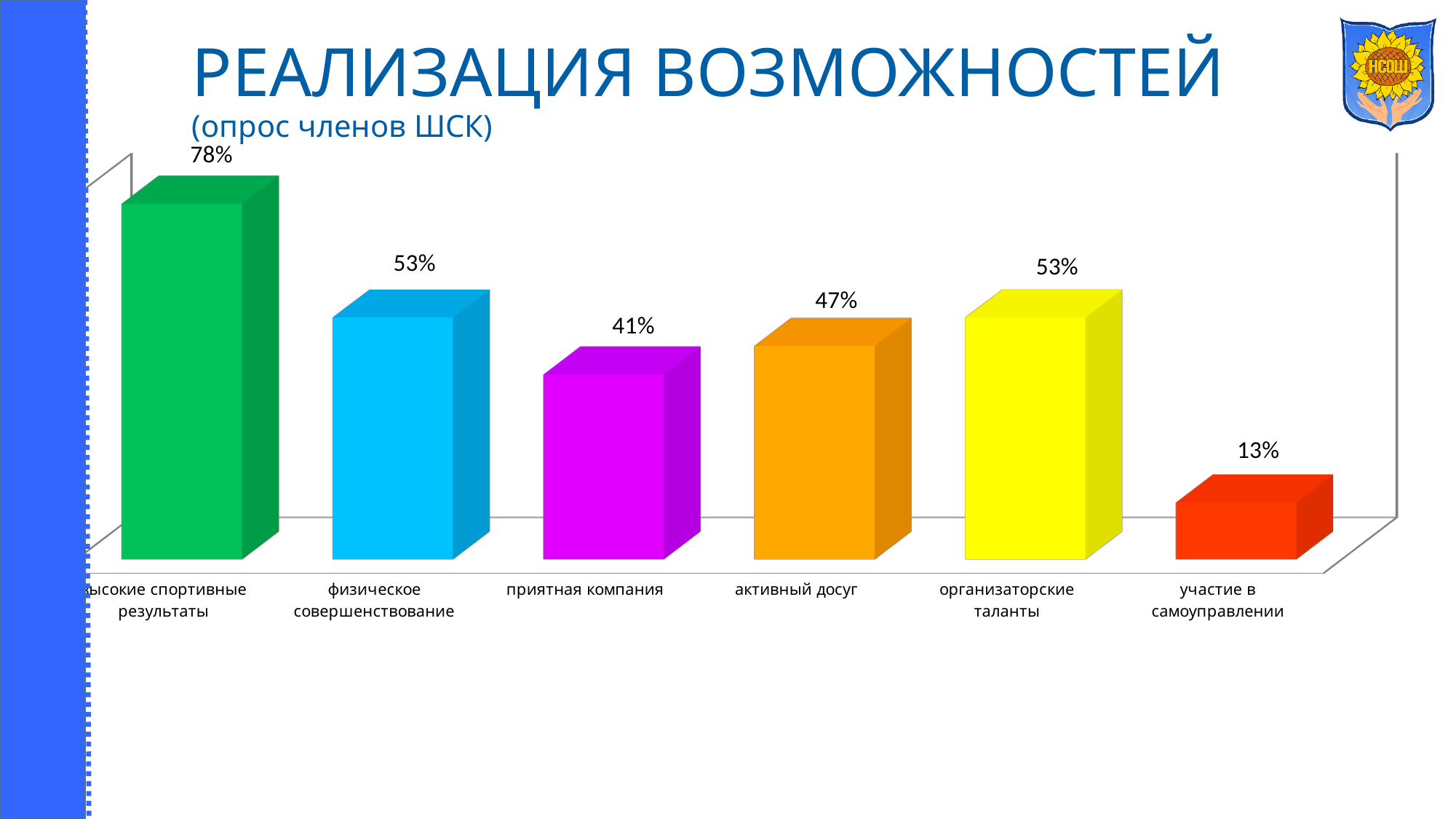
How many categories are shown in the chart? 6 What is the difference between the values for "активный досуг" and "приятная компания"? 6% What value is shown for "участие в самоуправлении"? 13% What value is shown for "физическое совершенствование"? 53% Which category has the lowest value? участие в самоуправлении Which is larger: the value for "активный досуг" or the value for "приятная компания"? активный досуг Which category has the highest value? высокие спортивные результаты What value is shown for "организаторские таланты"? 53% What is the difference between the highest value and the value for "участие в самоуправлении"? 65% What value is shown for "активный досуг"? 47% What kind of chart is shown on the slide? bar chart What value is shown for "приятная компания"? 41%